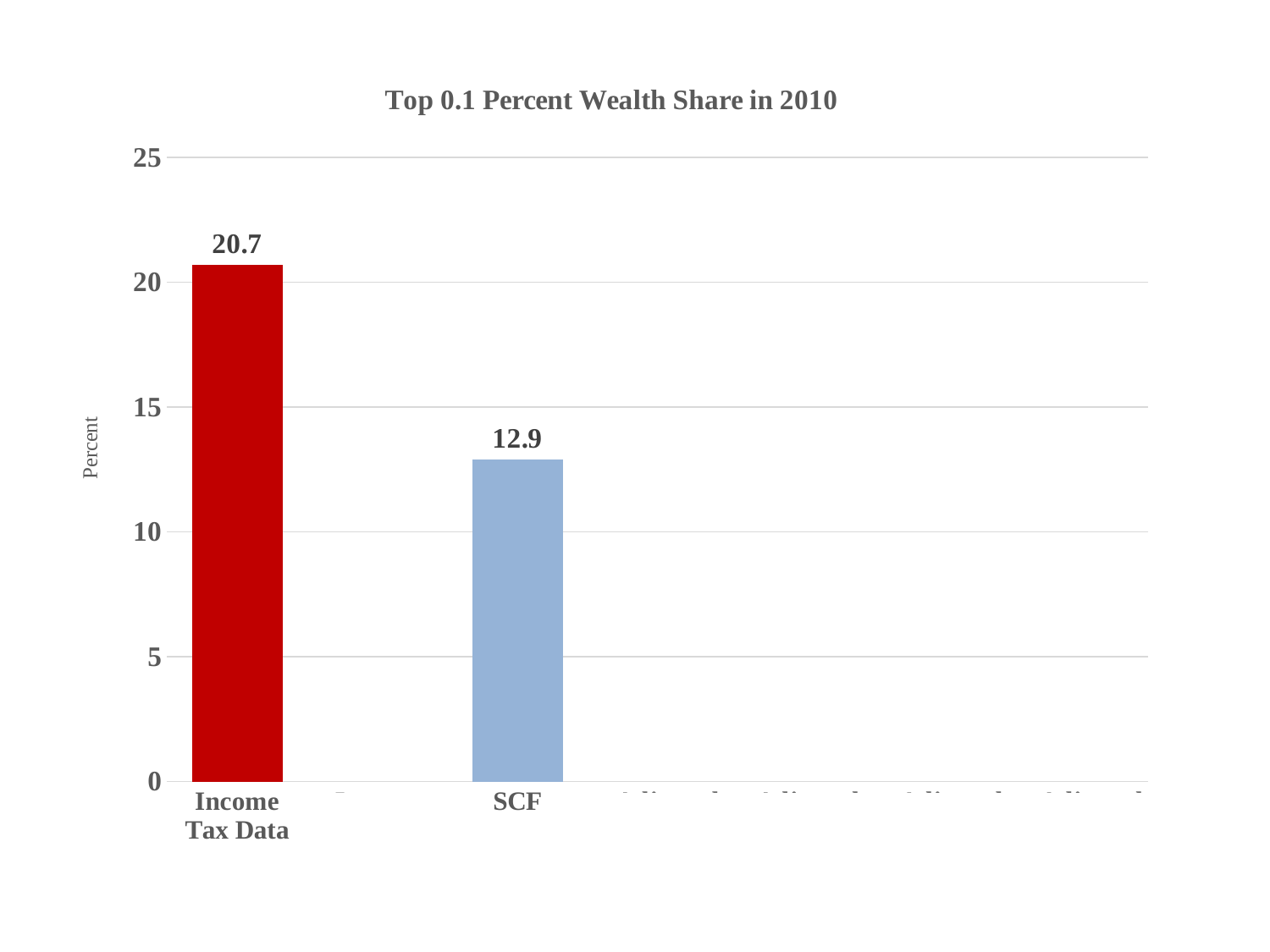
What is the label on the vertical axis? Percent What is the value for Income Tax Data? 20.7 What is the title of the chart? Top 0.1 Percent Wealth Share in 2010 Which is larger, the value for Income Tax Data or the value for SCF? Income Tax Data What is the value for SCF? 12.9 What is the difference between the values for Income Tax Data and SCF? 7.8 Which category has the lowest value? SCF How many bars with readable labels are shown in the chart? 2 Is the value for SCF greater or less than 15? less Which category has the highest value? Income Tax Data Is the value for Income Tax Data greater or less than 20? greater What kind of chart is this? bar chart